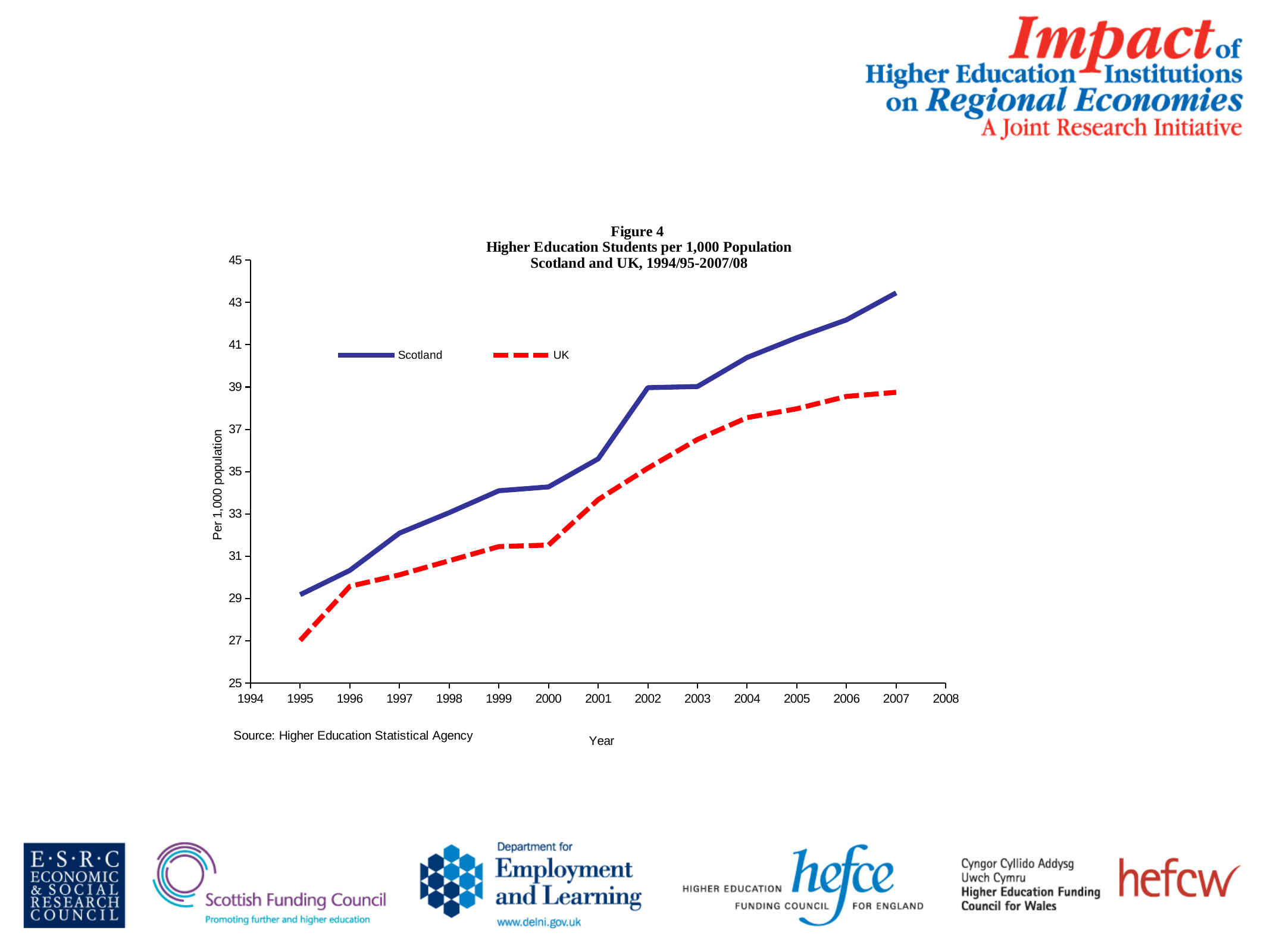
Which two series are plotted in the chart? Scotland and UK In 2007, which is larger, the value for Scotland or the value for the UK? Scotland How many series does the legend list? 2 Is the value for Scotland in 2007 greater or less than 41? greater In which year is the UK value lowest? 1995 Do the values for Scotland rise or fall from 1995 to 2007? rise In which year is the Scotland value highest? 2007 Is the value for the UK in 1995 greater or less than 29? less Do the values for the UK rise or fall from 1995 to 2007? rise What is the label on the vertical axis of the chart? Per 1,000 population What kind of chart is shown on the slide? line chart How many yearly data points are plotted for the Scotland series? 13